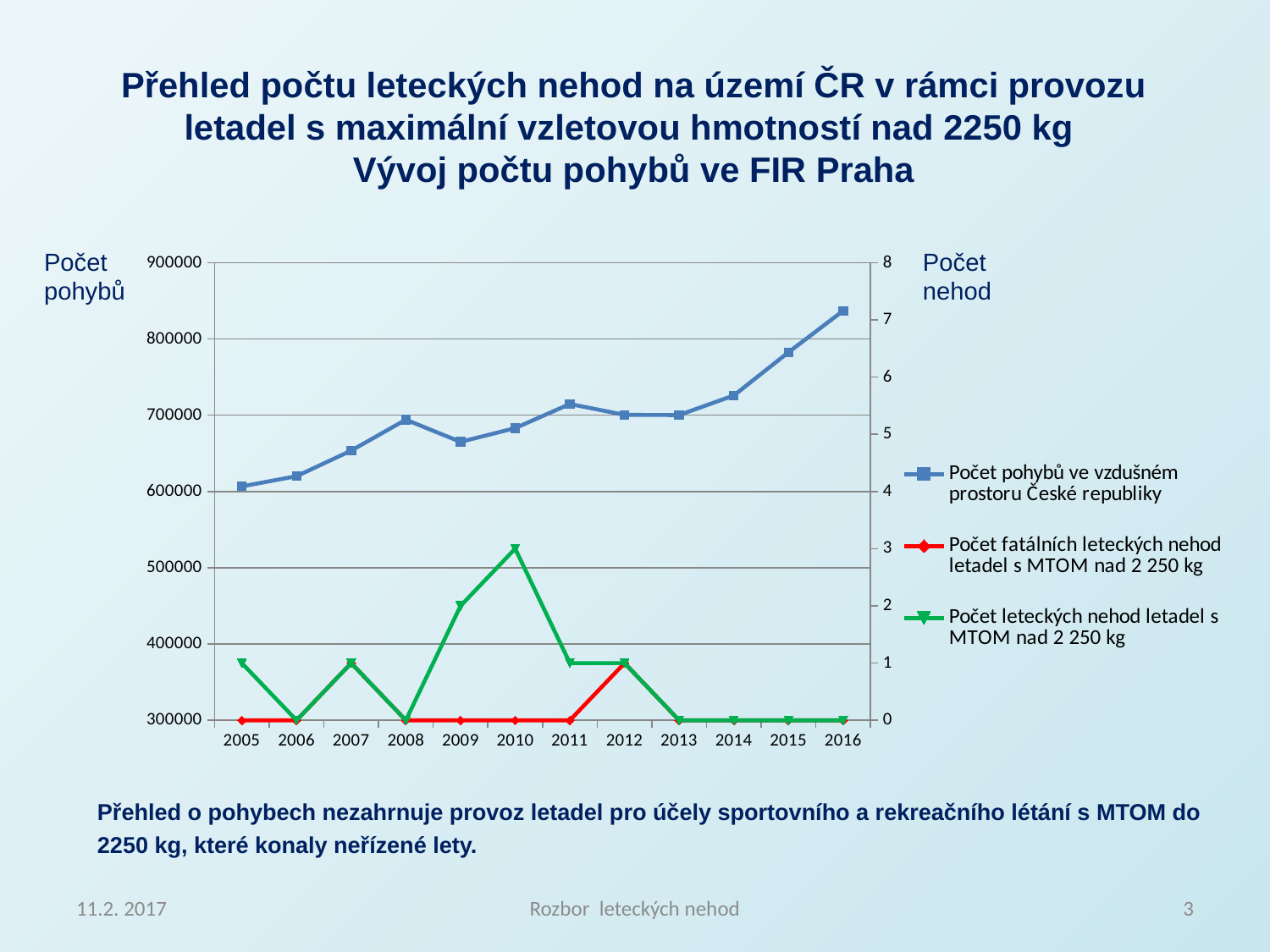
How many years are plotted along the x axis? 12 What is the value of 'Počet leteckých nehod letadel s MTOM nad 2 250 kg' in 2010? 3 What type of chart is shown on the slide? line chart What is the difference between 'Počet leteckých nehod letadel s MTOM nad 2 250 kg' in 2010 and in 2009? 1 Does 'Počet pohybů ve vzdušném prostoru České republiky' generally rise or fall from 2005 to 2016? rise Is the value for 'Počet pohybů ve vzdušném prostoru České republiky' in 2016 greater or less than 800000? greater In which year is 'Počet leteckých nehod letadel s MTOM nad 2 250 kg' highest? 2010 In which year is 'Počet pohybů ve vzdušném prostoru České republiky' lowest? 2005 What is the value of 'Počet fatálních leteckých nehod letadel s MTOM nad 2 250 kg' in 2012? 1 What is the value of 'Počet leteckých nehod letadel s MTOM nad 2 250 kg' in 2009? 2 In which year is 'Počet pohybů ve vzdušném prostoru České republiky' highest? 2016 How many series does the legend list? 3